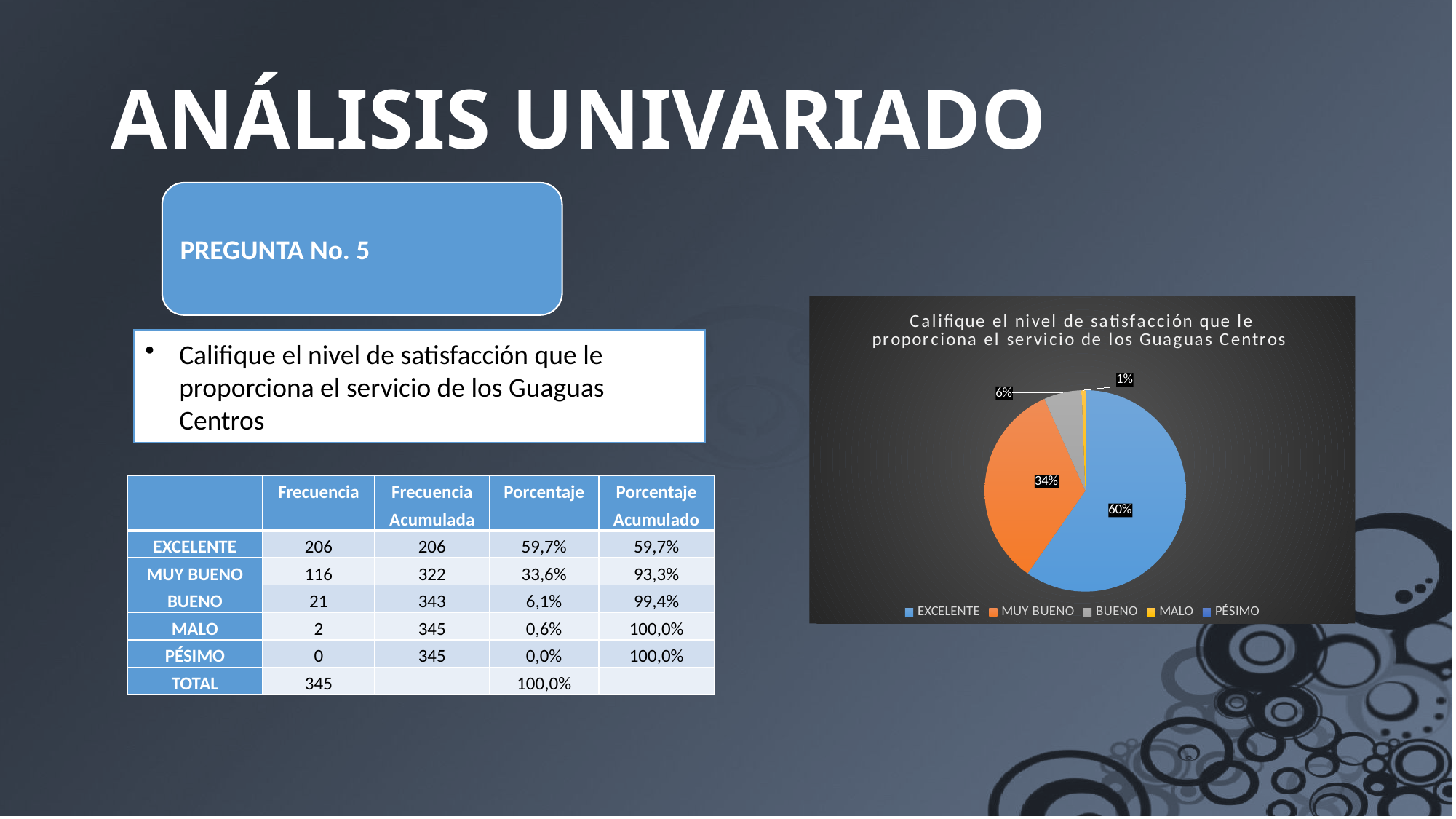
Which slice is larger in the pie chart, MUY BUENO or BUENO? MUY BUENO What percentage does the pie chart show for MALO? 1% What is the title of the pie chart? Califique el nivel de satisfacción que le proporciona el servicio de los Guaguas Centros What is the difference in percentage points between the EXCELENTE and MUY BUENO slices in the pie chart? 26 What percentage does the pie chart show for MUY BUENO? 34% What colour is the EXCELENTE slice in the pie chart? blue What percentage does the pie chart show for EXCELENTE? 60% What kind of chart is shown on the slide? pie chart How many categories does the legend of the pie chart list? 5 Which labelled slice in the pie chart is the smallest? MALO Which category has the largest slice in the pie chart? EXCELENTE What percentage does the pie chart show for BUENO? 6%